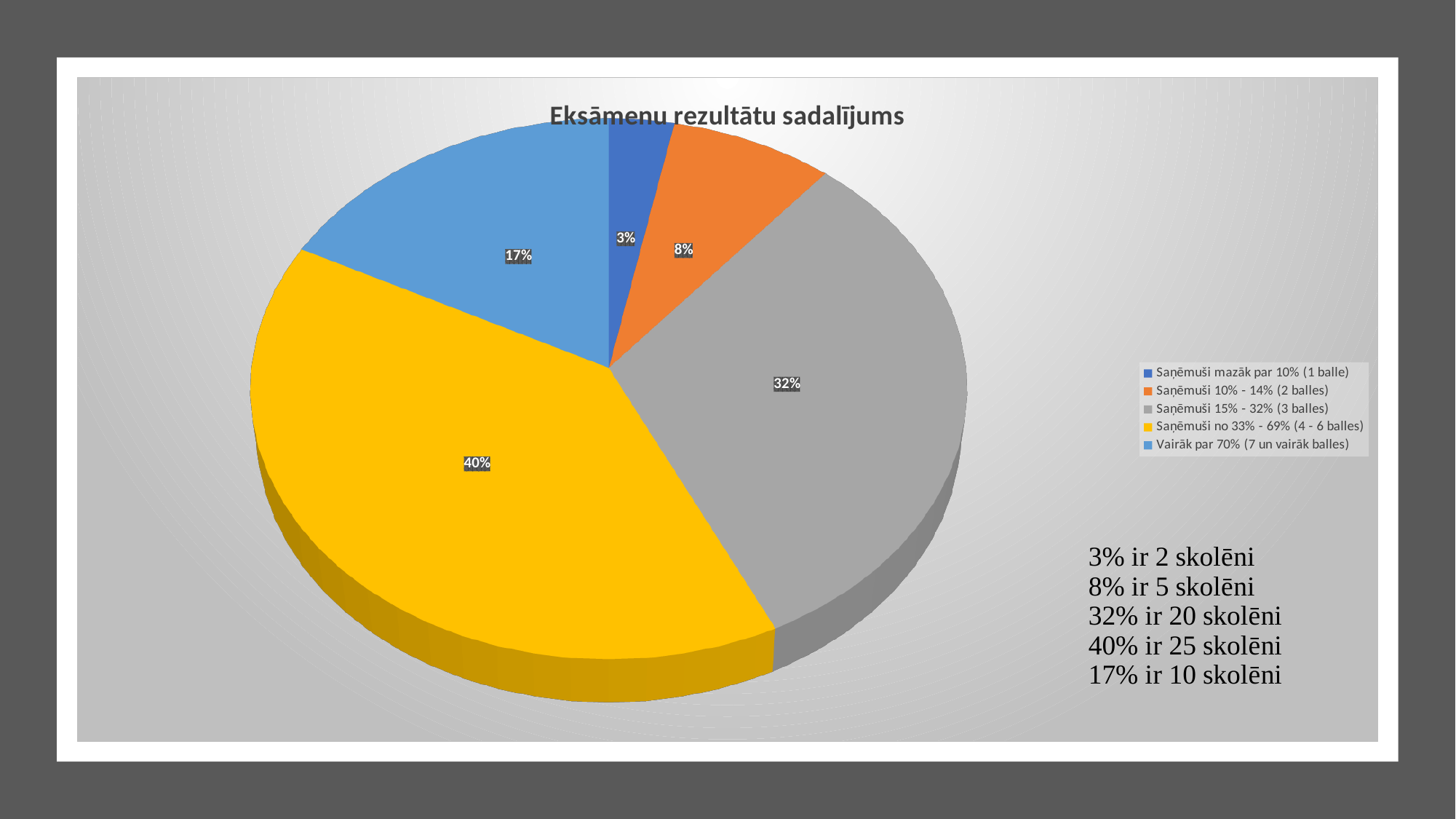
What share of the pie is labelled for 'Vairāk par 70% (7 un vairāk balles)'? 17% Which category has the largest slice of the pie? Saņēmuši no 33% - 69% (4 - 6 balles) What share of the pie is labelled for 'Saņēmuši mazāk par 10% (1 balle)'? 3% What kind of chart is shown on the slide? Pie chart How many categories does the pie chart have? 5 What is the title of the chart? Eksāmenu rezultātu sadalījums What share of the pie is labelled for 'Saņēmuši no 33% - 69% (4 - 6 balles)'? 40% Which category has the smallest slice of the pie? Saņēmuši mazāk par 10% (1 balle) What is the difference in percentage points between the 'Saņēmuši no 33% - 69% (4 - 6 balles)' slice and the 'Saņēmuši 15% - 32% (3 balles)' slice? 8 percentage points Which slice is larger: 'Vairāk par 70% (7 un vairāk balles)' or 'Saņēmuši 10% - 14% (2 balles)'? Vairāk par 70% (7 un vairāk balles)